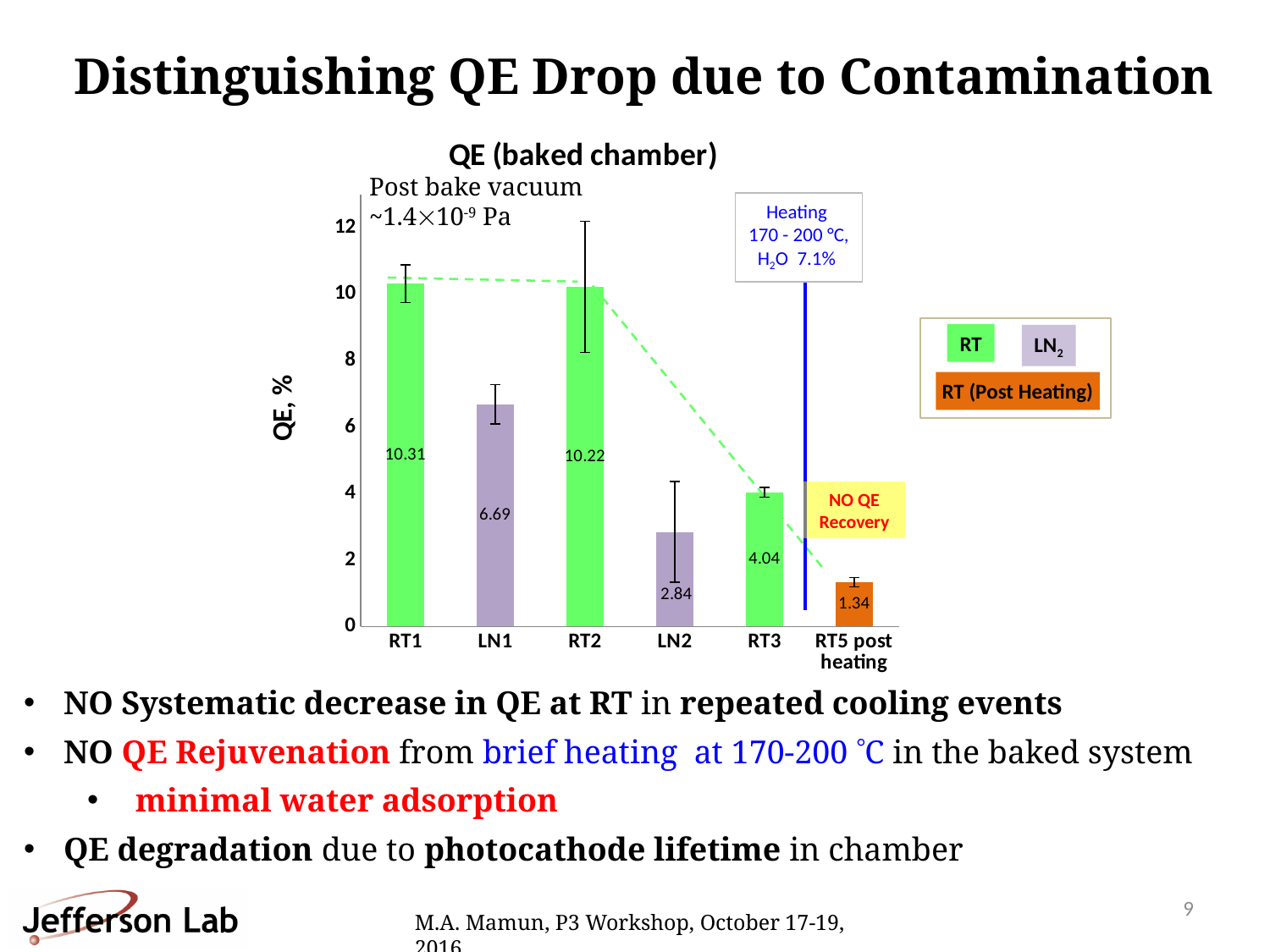
What is the difference between the QE values for RT1 and RT2? 0.09 How many categories are shown on the x axis? 6 What is the QE value for RT1? 10.31 What is the QE value for LN2? 2.84 What type of chart is shown? bar chart Is the QE value for LN1 greater or less than 6? greater Which has a larger QE value, RT3 or LN2? RT3 What is the QE value for RT5 post heating? 1.34 How many entries does the legend list? 3 Which category has the lowest QE value? RT5 post heating What is the difference between the QE values for LN1 and LN2? 3.85 Which category has the highest QE value? RT1